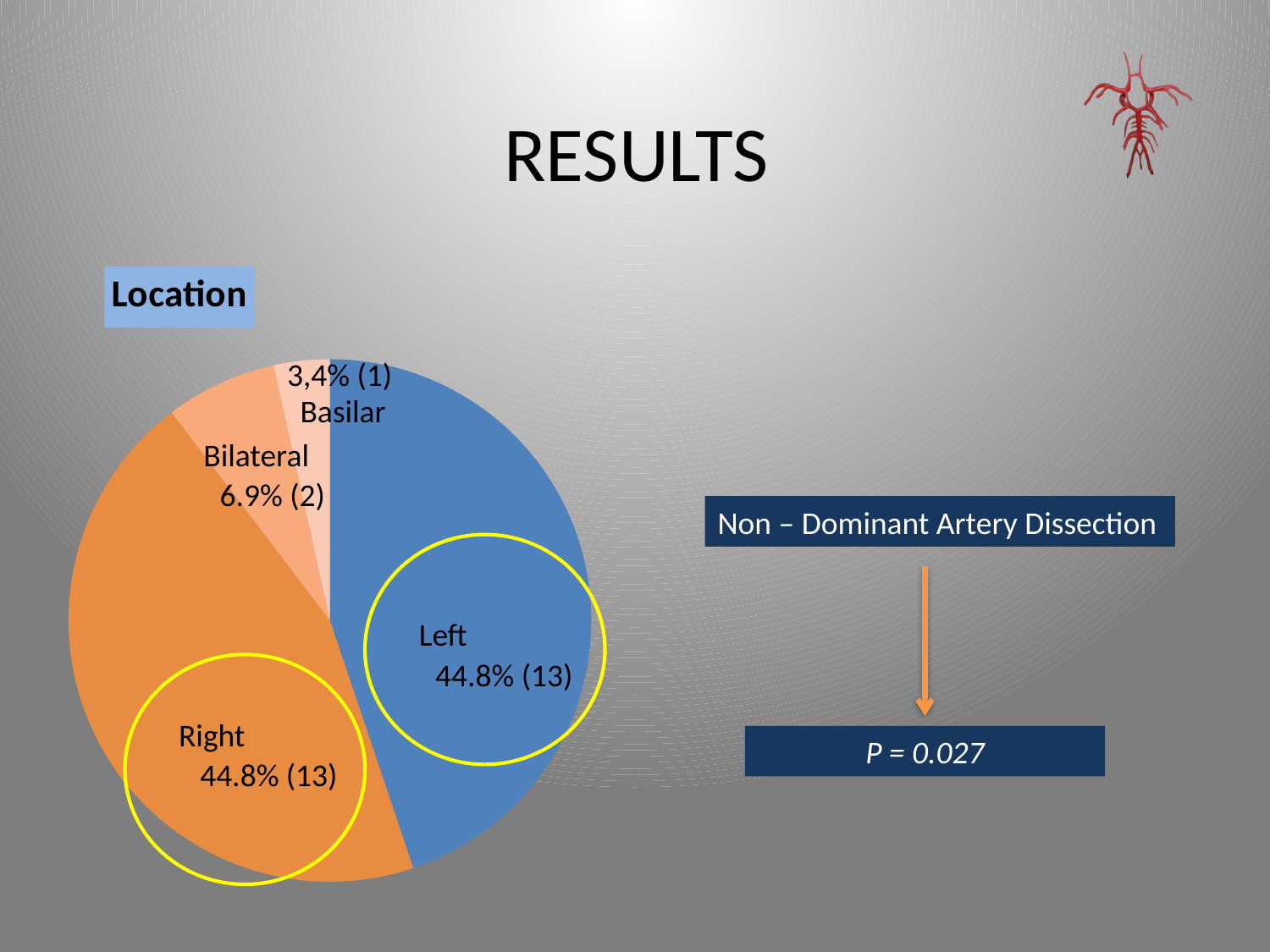
How many slices does the Location pie chart have? 4 How many more cases are in the Left slice than in the Bilateral slice of the Location pie chart? 11 What percentage of the Location pie chart is the Right slice? 44.8% What percentage of the Location pie chart is the Left slice? 44.8% How many cases are in the Basilar slice of the Location pie chart? 1 How many cases are in the Bilateral slice of the Location pie chart? 2 What percentage of the Location pie chart is the Basilar slice? 3,4% What kind of chart is shown under the heading "Location"? pie chart Which has more cases in the Location pie chart, Bilateral or Basilar? Bilateral Which slice of the Location pie chart is the smallest? Basilar How many cases are in the Left slice of the Location pie chart? 13